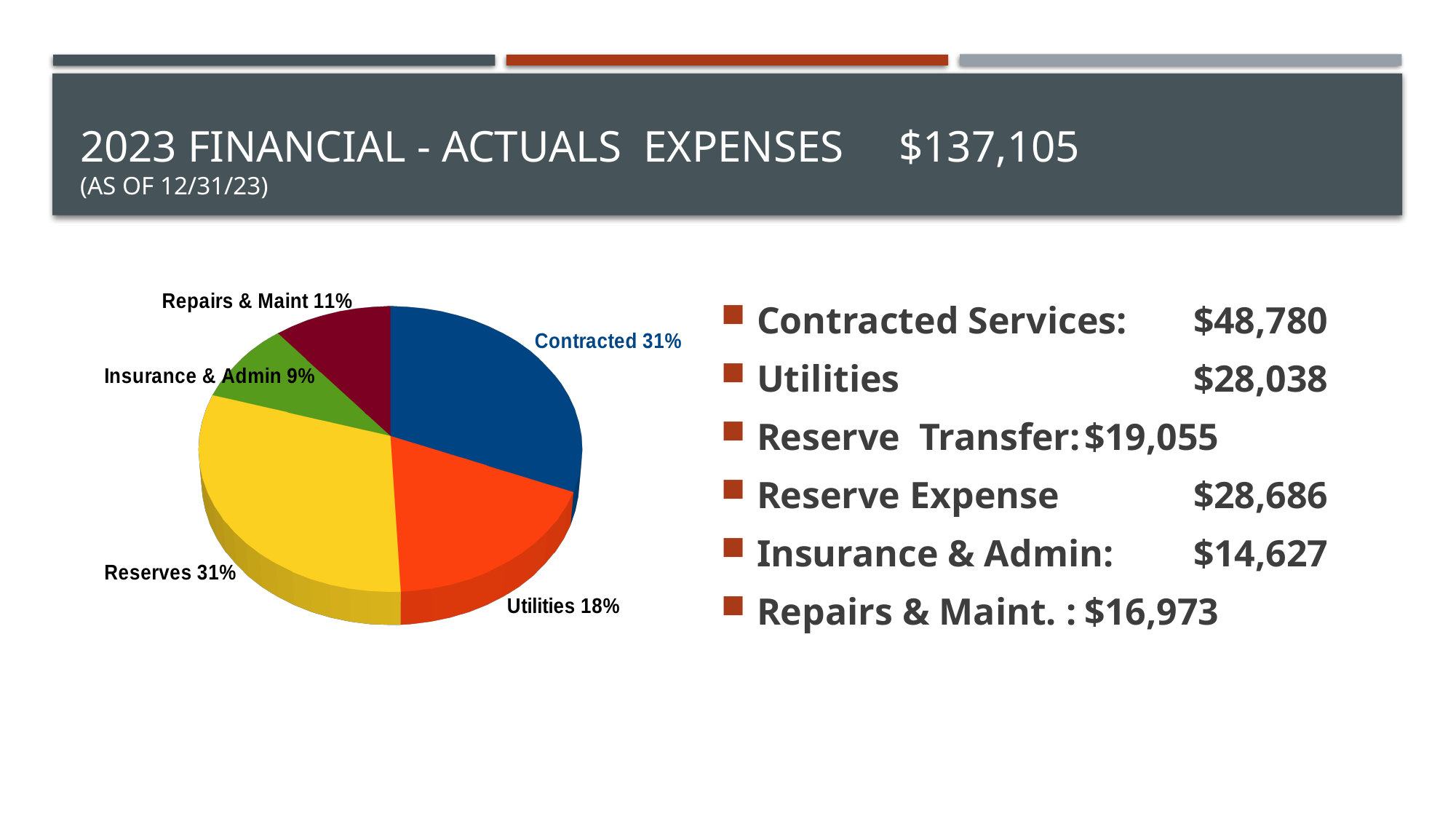
Which slice of the pie chart has the smallest share? Insurance & Admin What colour is the Contracted slice in the pie chart? Blue By how many percentage points does the Utilities slice exceed the Insurance & Admin slice? 9 percentage points What percentage is shown for Insurance & Admin in the pie chart? 9% What percentage is shown for Reserves in the pie chart? 31% What kind of chart is shown on the slide? Pie chart How many slices does the pie chart have? 5 What percentage of the pie chart is labelled Contracted? 31% What percentage is shown for Repairs & Maint in the pie chart? 11% Which slice is larger in the pie chart, Utilities or Repairs & Maint? Utilities What share does the Utilities slice show in the pie chart? 18% By how many percentage points does the Repairs & Maint slice exceed the Insurance & Admin slice? 2 percentage points